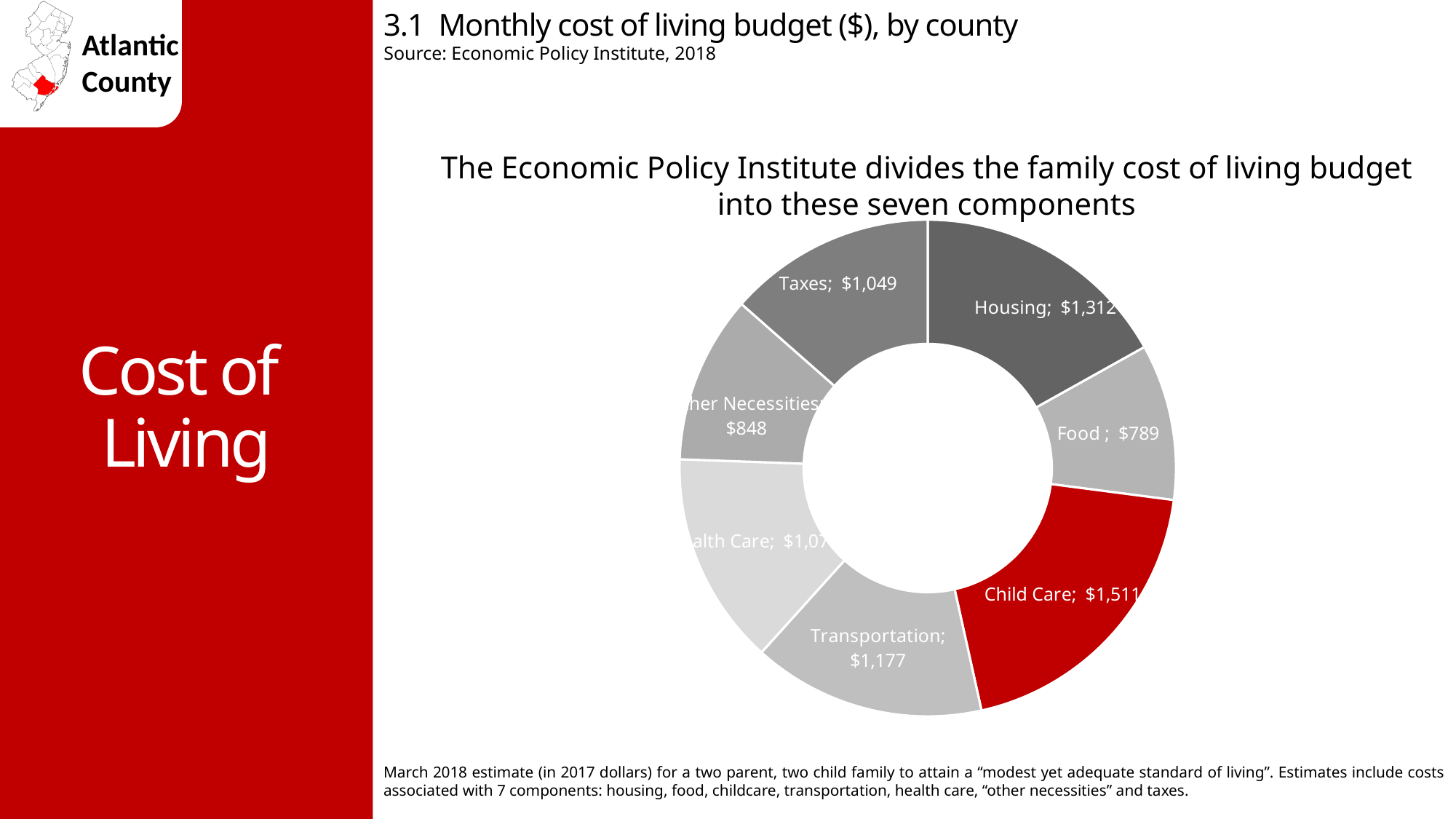
What is the monthly cost for Transportation shown on the chart? $1,177 Which component has the largest monthly cost in the chart? Child Care What is the monthly cost for Other Necessities shown on the chart? $848 What is the difference between the Transportation cost and the Food cost? $388 What is the monthly cost for Food shown on the chart? $789 Which component has the smallest monthly cost in the chart? Food How many components (slices) does the chart show? 7 Which is larger, the Housing cost or the Food cost? Housing What is the monthly cost for Child Care shown on the chart? $1,511 What is the difference between the Child Care cost and the Taxes cost? $462 What type of chart is used on the slide? Doughnut (pie) chart What is the monthly cost for Taxes shown on the chart? $1,049